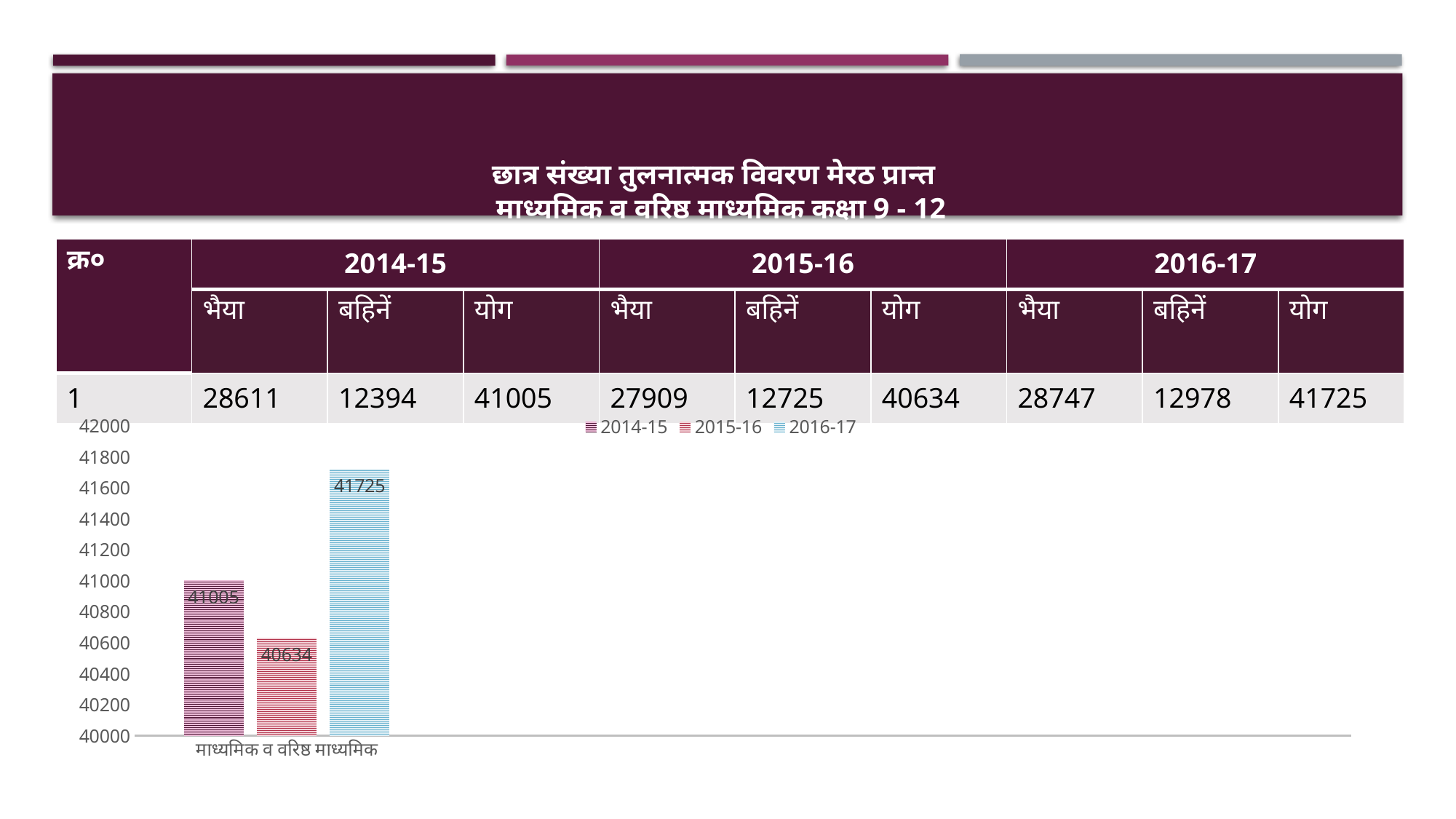
Which is larger, the value for 2014-15 or the value for 2016-17? 2016-17 Which series has the highest value in the chart? 2016-17 What is the value for 2015-16 in the chart? 40634 How many series does the legend list? 3 Is the value for 2015-16 greater or less than 41000? less What is the difference between the 2016-17 value and the 2015-16 value? 1091 What kind of chart is shown on the slide? bar chart Which series has the lowest value in the chart? 2015-16 What is the value for 2016-17 in the chart? 41725 What is the value for 2014-15 in the chart? 41005 What is the difference between the 2014-15 value and the 2015-16 value? 371 What is the lowest value shown on the vertical axis of the chart? 40000